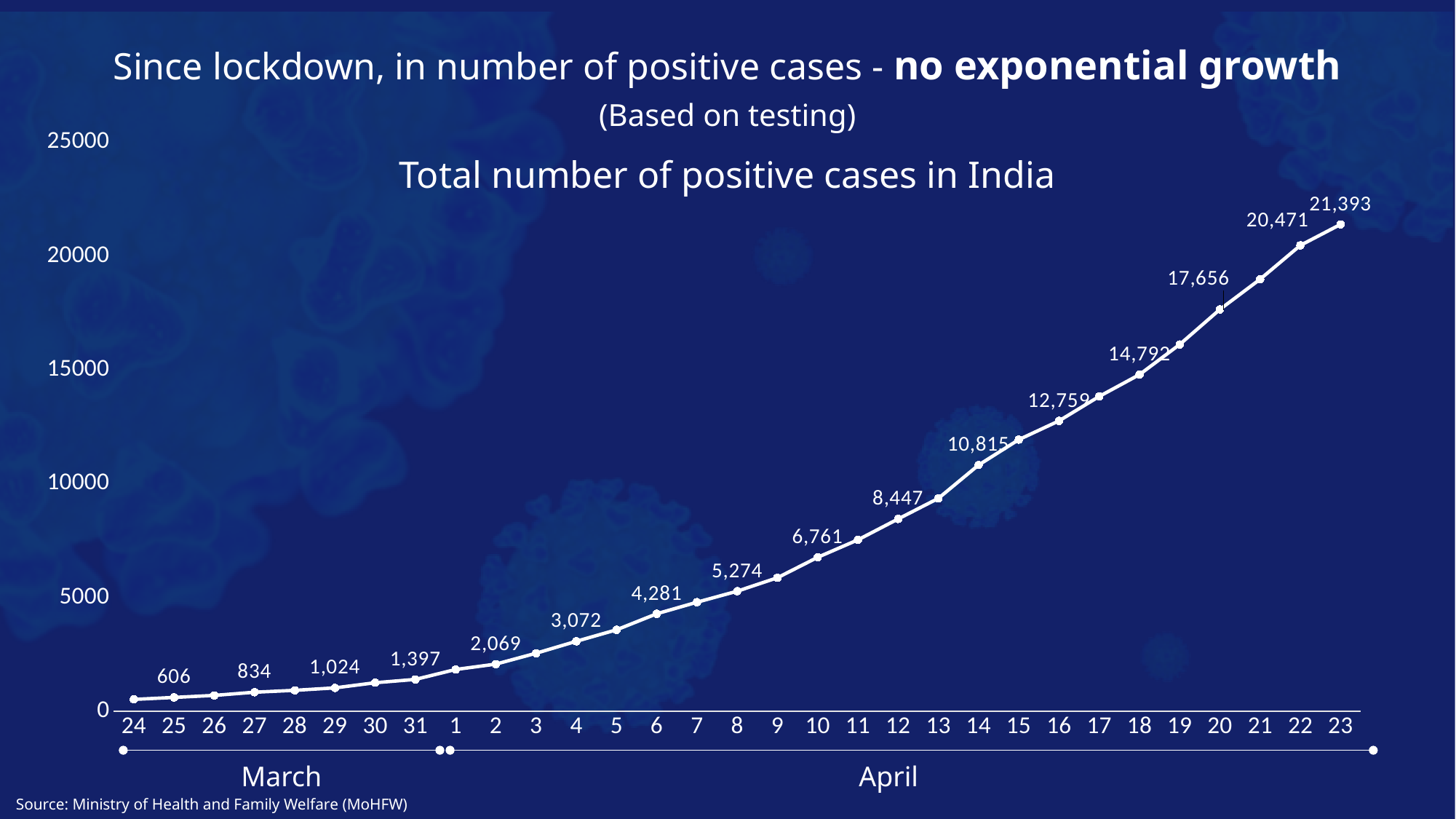
What is the total number of positive cases in India on April 23? 21,393 Is the total number of positive cases on April 17 greater or less than 15000? less What is the total number of positive cases on April 2? 2,069 Which date has the highest total number of positive cases? April 23 What is the difference in total positive cases between April 18 and April 20? 2,864 What is the difference in total positive cases between April 22 and April 23? 922 What is the total number of positive cases on March 25? 606 What is the total number of positive cases on April 14? 10,815 What is the title of the chart? Total number of positive cases in India What type of chart is shown on the slide? line chart Which date has the lowest total number of positive cases? March 24 Do the total positive cases rise or fall from March 24 to April 23? rise